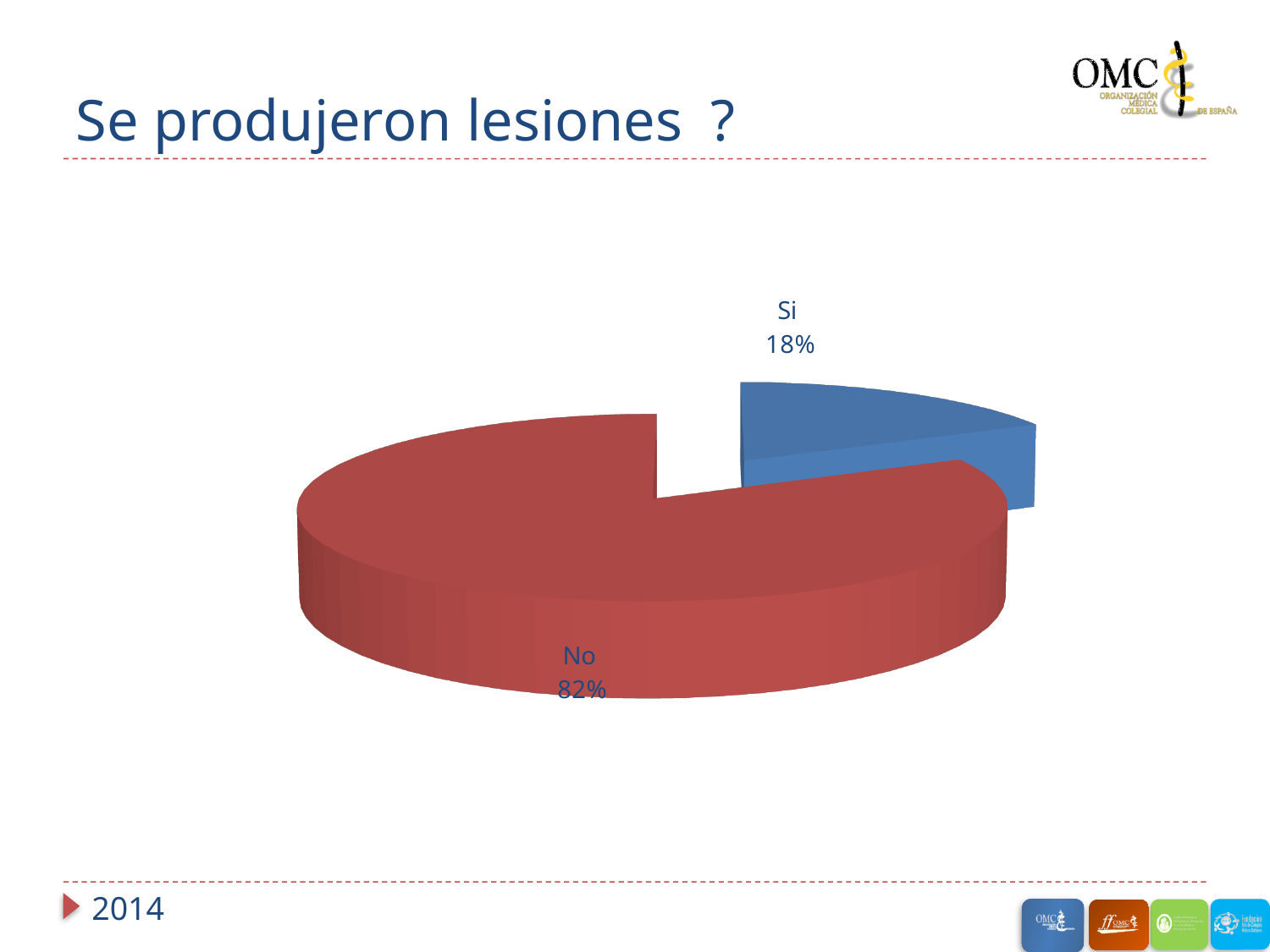
Which slice of the pie is the largest? No What share of the pie does the "Si" slice represent? 18% What colour is the "Si" slice? blue What colour is the "No" slice? red Which slice of the pie is the smallest? Si What is the difference in percentage points between the "No" and "Si" slices? 64 Which is larger, the "Si" slice or the "No" slice? No How many slices does the pie chart have? 2 What kind of chart is shown on the slide? pie chart What share of the pie does the "No" slice represent? 82%